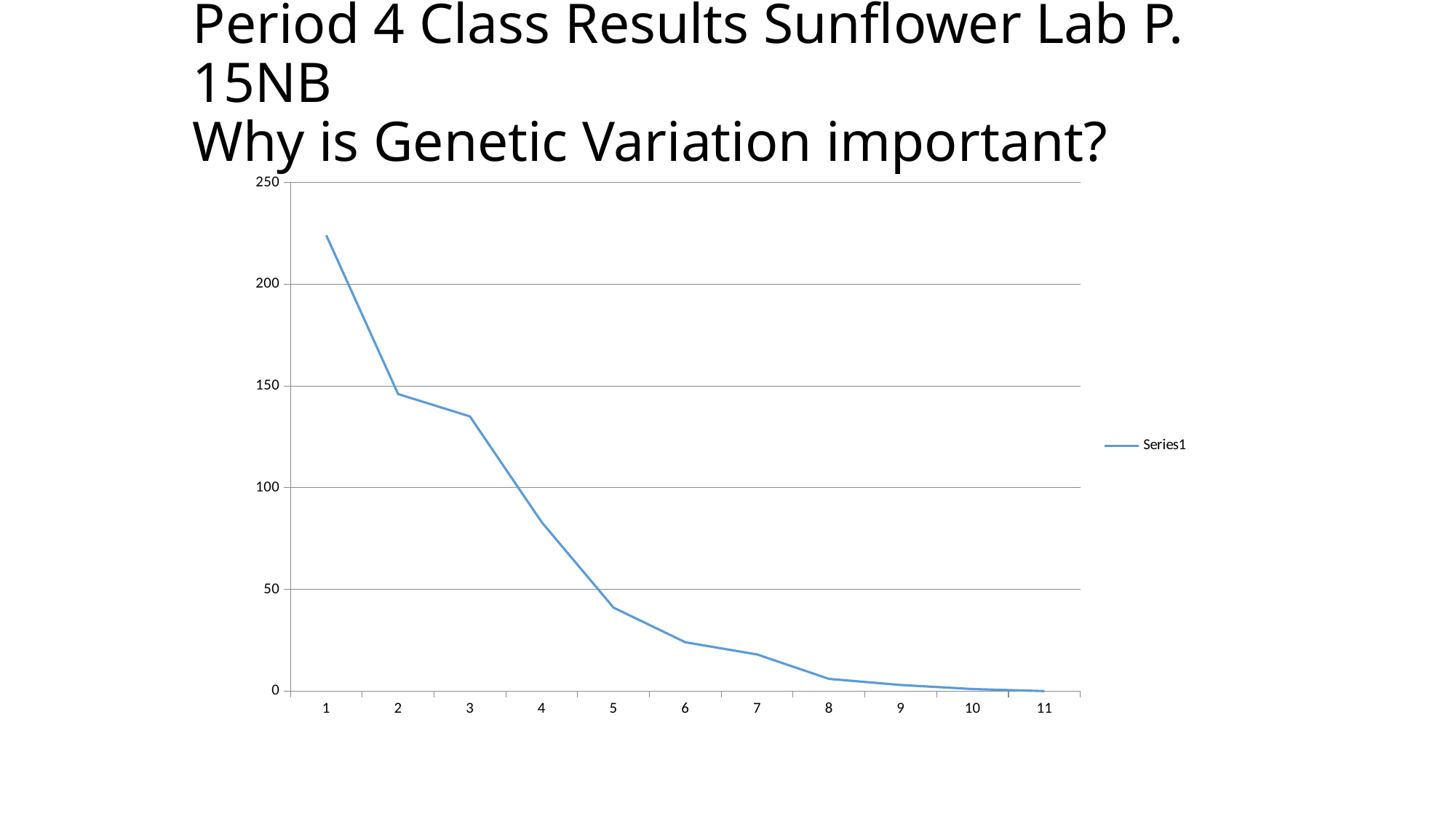
How many series does the legend list? 1 Do the values rise or fall as you move from 1 to 11 along the x axis? fall How many points are plotted along the x axis? 11 Which has the larger value, x = 2 or x = 4? 2 Is the value at x = 5 greater or less than 50? less What is the name of the series shown in the legend? Series1 What kind of chart is shown on the slide? line chart Is the value at x = 3 greater or less than 150? less What is the highest value shown on the y axis? 250 Is the value at x = 1 greater or less than 200? greater Which x-axis category has the lowest value? 11 Which x-axis category has the highest value? 1